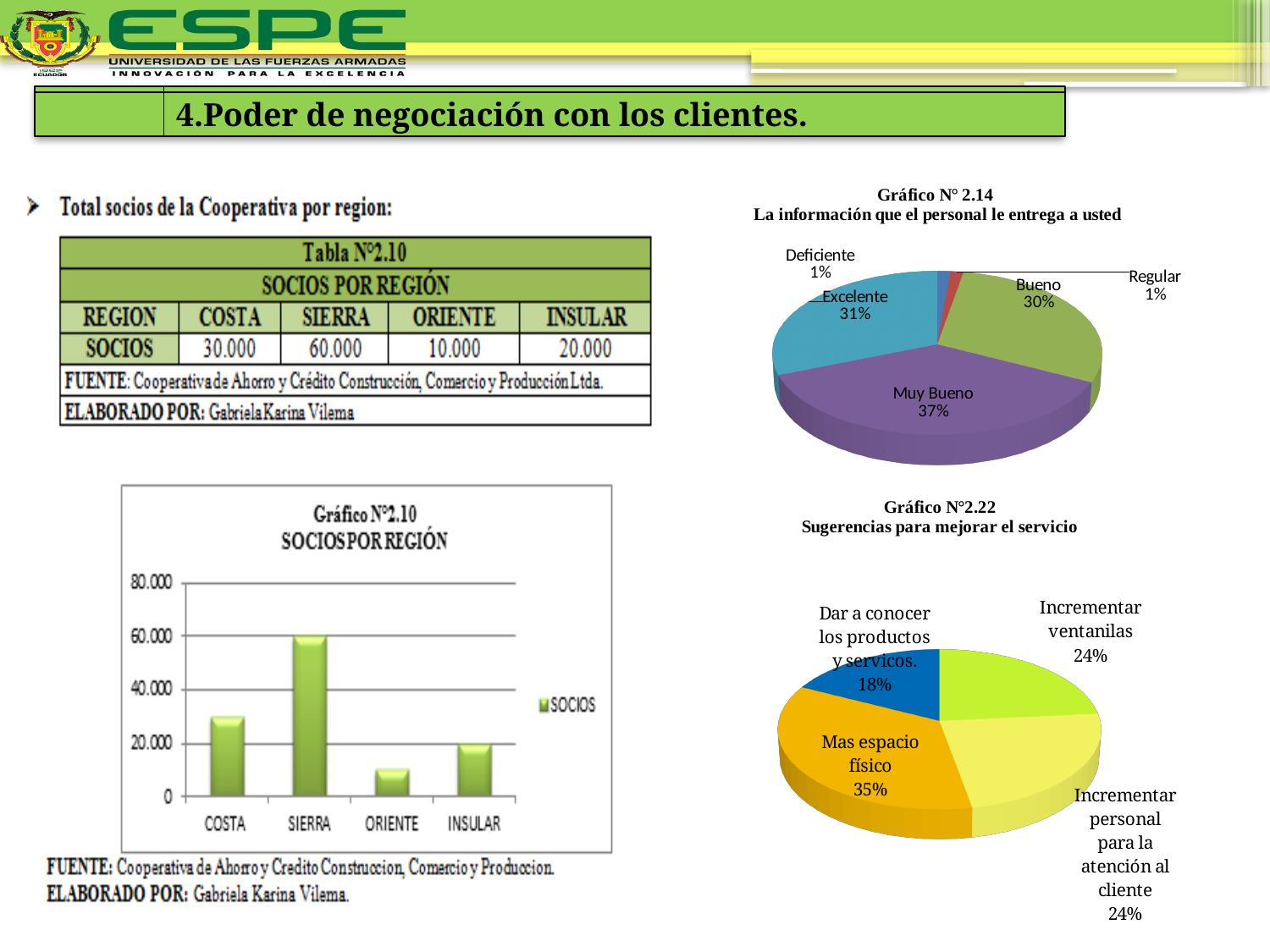
In the chart 'Gráfico N°2.10 SOCIOS POR REGIÓN', which is larger, the value for INSULAR or the value for ORIENTE? INSULAR In the pie chart 'Gráfico N°2.22 Sugerencias para mejorar el servicio', how many slices does the pie have? 4 In the pie chart 'Gráfico N°2.22 Sugerencias para mejorar el servicio', what share is labelled 'Mas espacio físico'? 35% In the pie chart 'Gráfico N° 2.14 La información que el personal le entrega a usted', what is the difference between the shares for Excelente and Bueno? 1% In the chart 'Gráfico N°2.10 SOCIOS POR REGIÓN', which region has the highest number of socios? SIERRA In the chart 'Gráfico N°2.10 SOCIOS POR REGIÓN', which region has the lowest number of socios? ORIENTE In the pie chart 'Gráfico N° 2.14 La información que el personal le entrega a usted', what share is labelled 'Muy Bueno'? 37% In the chart 'Gráfico N°2.10 SOCIOS POR REGIÓN', how many regions are shown on the x axis? 4 In the chart 'Gráfico N°2.10 SOCIOS POR REGIÓN', is the value for COSTA greater or less than 20.000? greater In the chart 'Gráfico N°2.10 SOCIOS POR REGIÓN', what kind of chart is shown? bar chart In the chart 'Gráfico N°2.10 SOCIOS POR REGIÓN', what is the value for SIERRA? 60.000 In the pie chart 'Gráfico N° 2.14 La información que el personal le entrega a usted', which category has the largest share? Muy Bueno